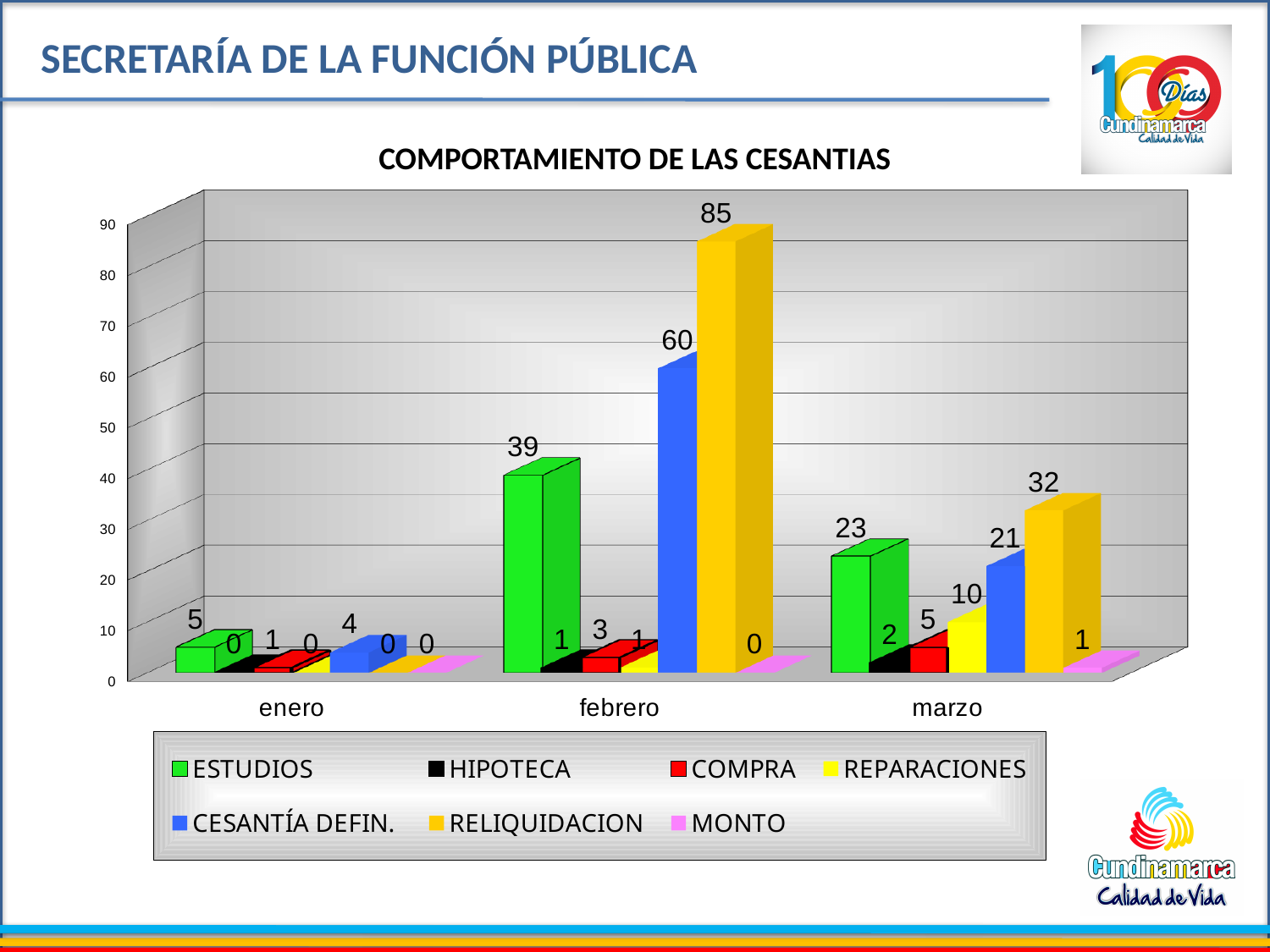
Does the ESTUDIOS value rise or fall from febrero to marzo? fall Which is larger in marzo, REPARACIONES or COMPRA? REPARACIONES How many series does the legend list? 7 How many categories are shown on the x axis? 3 What is the title of the chart? COMPORTAMIENTO DE LAS CESANTIAS What is the value of RELIQUIDACION in febrero? 85 In which month is the RELIQUIDACION value highest? febrero What is the value of CESANTÍA DEFIN. in enero? 4 What is the value of ESTUDIOS in marzo? 23 In which month is the ESTUDIOS value lowest? enero What is the difference between CESANTÍA DEFIN. in febrero and CESANTÍA DEFIN. in marzo? 39 What type of chart is shown on the slide? bar chart